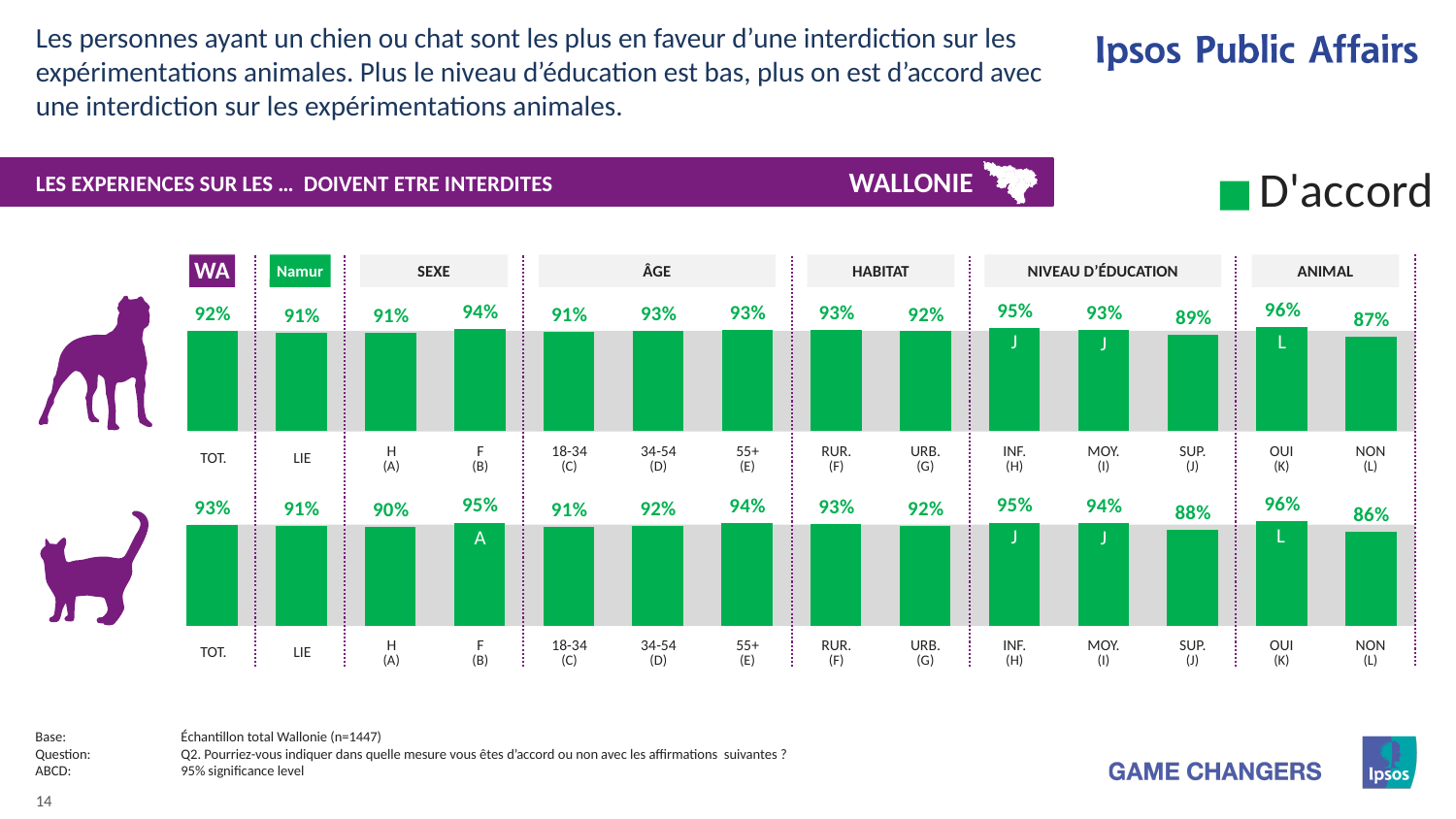
What is the legend entry shown at the top right of the slide? D'accord In the bottom row (cat) chart, do the values rise or fall across the age groups from 18-34 to 55+? Rise In the top row (dog) chart, which category has the highest value? OUI (K) In the top row (dog) chart, what is the difference between the values for OUI (K) and NON (L)? 9% In the bottom row (cat) chart, what is the value for NON (L) under ANIMAL? 86% How many categories (bars) are plotted in the top row (dog) chart? 14 In the bottom row (cat) chart, what is the difference between the values for INF. (H) and SUP. (J)? 7% In the bottom row (cat) chart, which is larger, the value for H (A) or the value for F (B)? F (B) In the top row (dog) chart, what is the value for SUP. (J) under NIVEAU D'ÉDUCATION? 89% What kind of chart is used on this slide? Bar chart In the bottom row (cat) chart, which category has the lowest value? NON (L) In the top row (dog) chart, what is the value for TOT.? 92%